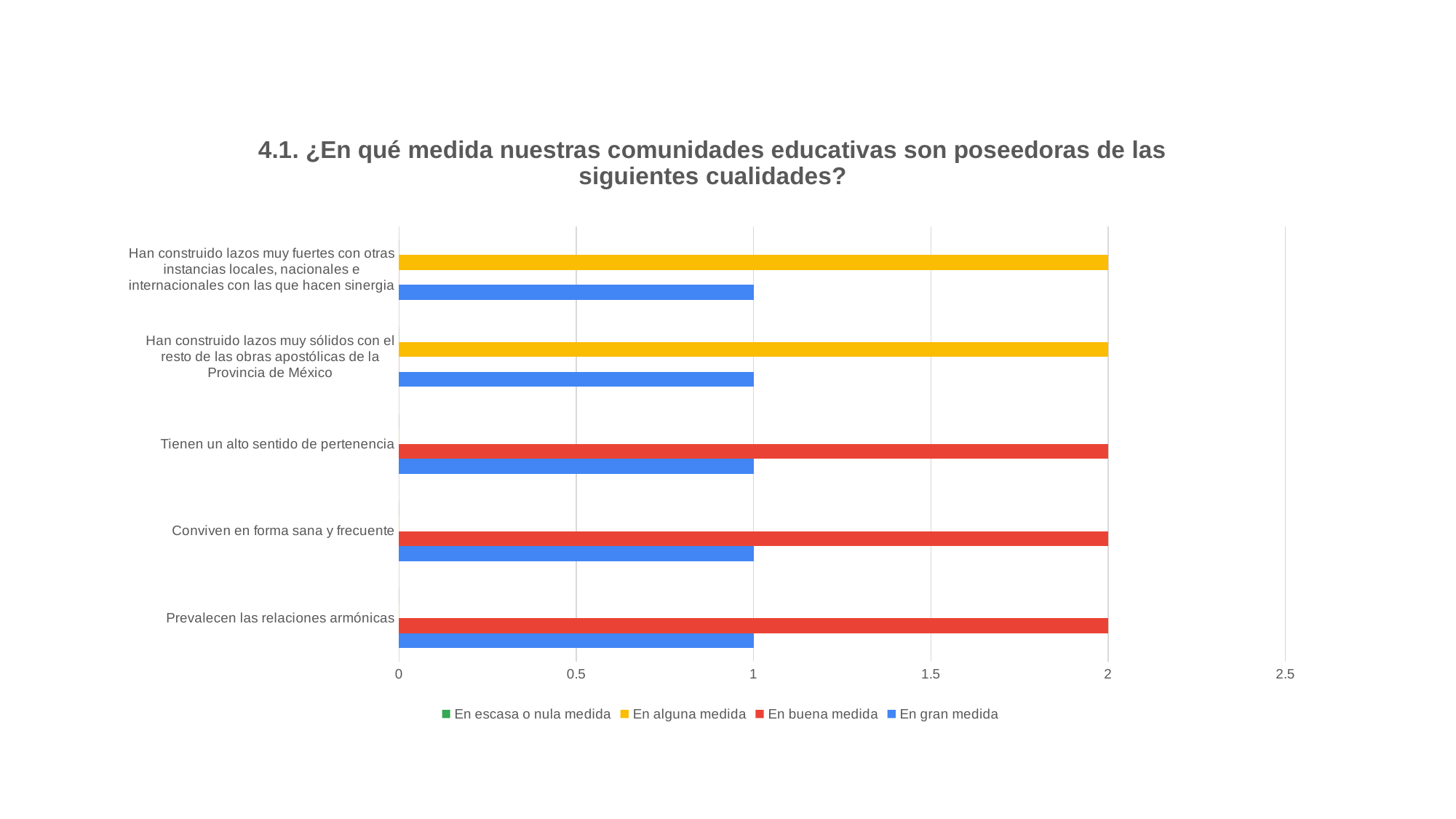
What is the highest value shown on the horizontal axis? 2.5 Which series is shown in blue in the legend? En gran medida Is the value of "En buena medida" for "Prevalecen las relaciones armónicas" greater or less than 1.5? greater What is the value of "En gran medida" for "Prevalecen las relaciones armónicas"? 1 For "Tienen un alto sentido de pertenencia", which is larger: "En buena medida" or "En gran medida"? En buena medida What is the value of "En gran medida" for "Tienen un alto sentido de pertenencia"? 1 What is the value of "En alguna medida" for "Han construido lazos muy sólidos con el resto de las obras apostólicas de la Provincia de México"? 2 How many series does the legend list? 4 What kind of chart is shown on the slide? bar chart What is the difference between "En alguna medida" and "En gran medida" for "Han construido lazos muy fuertes con otras instancias locales, nacionales e internacionales con las que hacen sinergia"? 1 How many categories are listed on the vertical axis of the chart? 5 What is the value of "En buena medida" for "Conviven en forma sana y frecuente"? 2